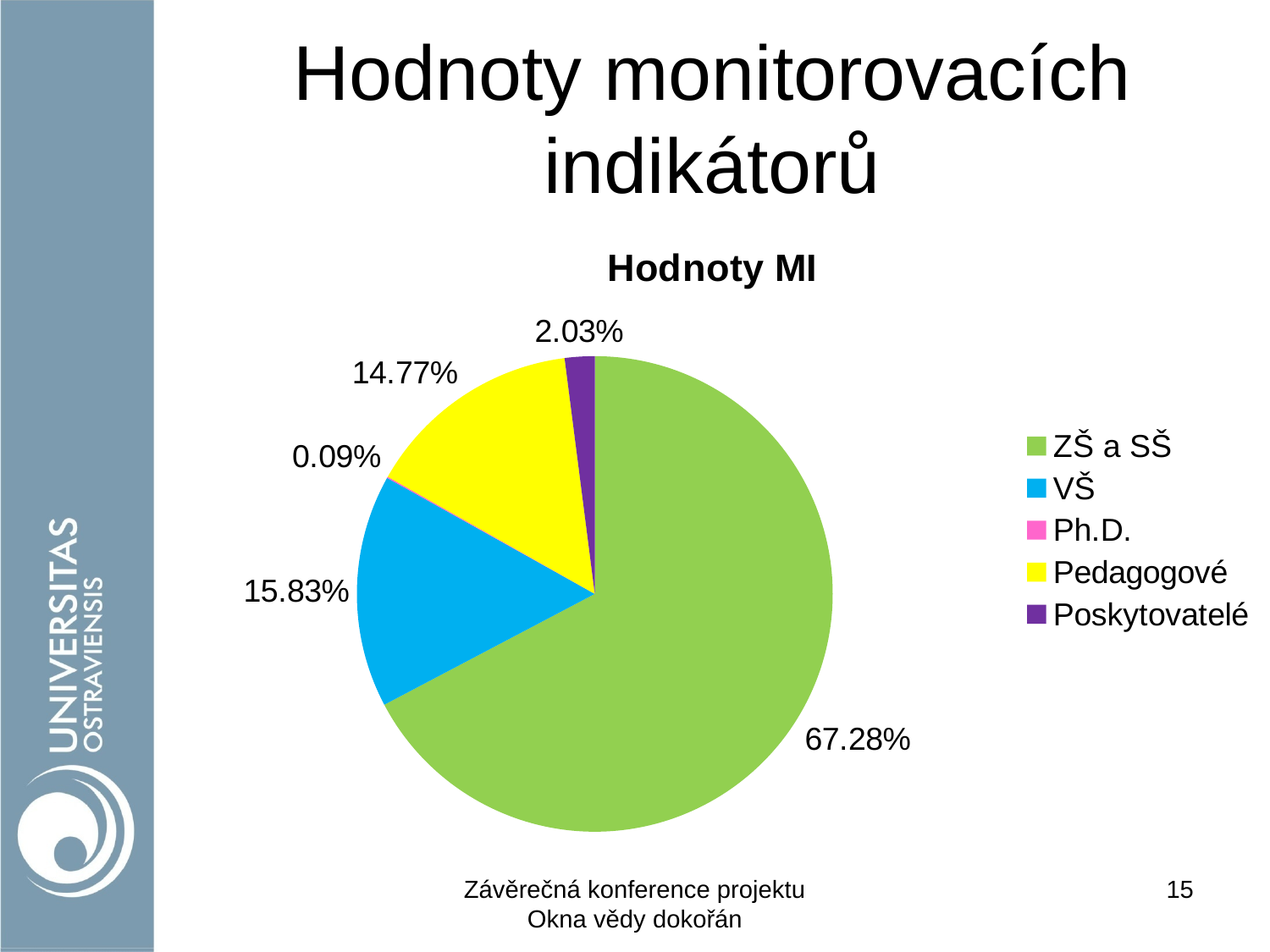
What kind of chart is shown on the slide? pie chart Which is larger, the VŠ slice or the Pedagogové slice? VŠ Which category has the smallest share of the pie? Ph.D. What percentage does the Poskytovatelé slice represent? 2.03% What percentage does the Pedagogové slice represent? 14.77% What percentage does the Ph.D. slice represent? 0.09% What percentage does the ZŠ a SŠ slice represent? 67.28% What percentage does the VŠ slice represent? 15.83% How many categories does the legend list? 5 What is the difference in percentage points between the ZŠ a SŠ slice and the VŠ slice? 51.45 What is the title of the chart? Hodnoty MI Which category has the largest share of the pie? ZŠ a SŠ